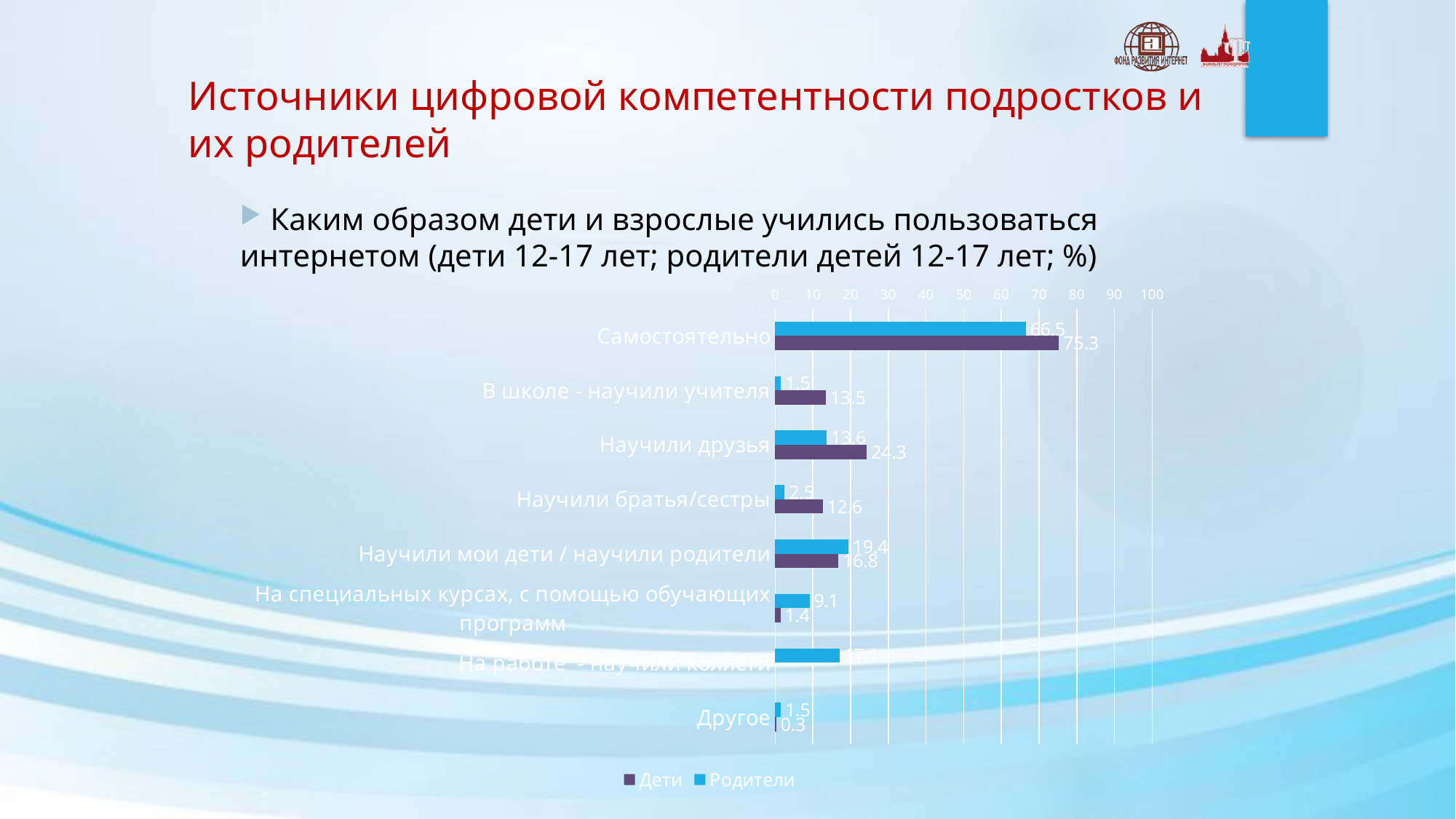
What kind of chart is shown on the slide? bar chart How many series does the legend list? 2 What is the value for Родители in the category Самостоятельно? 66.5 Which series is shown in purple in the legend? Дети What is the difference between the Дети and Родители values in the category Самостоятельно? 8.8 What is the value for Родители in the category На работе - научили коллеги? 17.1 How many categories are shown on the chart? 8 Which category has the highest value for Дети? Самостоятельно In the category Научили мои дети / научили родители, which series has the larger value, Дети or Родители? Родители What is the value for Дети in the category Самостоятельно? 75.3 What is the value for Дети in the category Научили друзья? 24.3 Which category has the lowest value for Дети? Другое